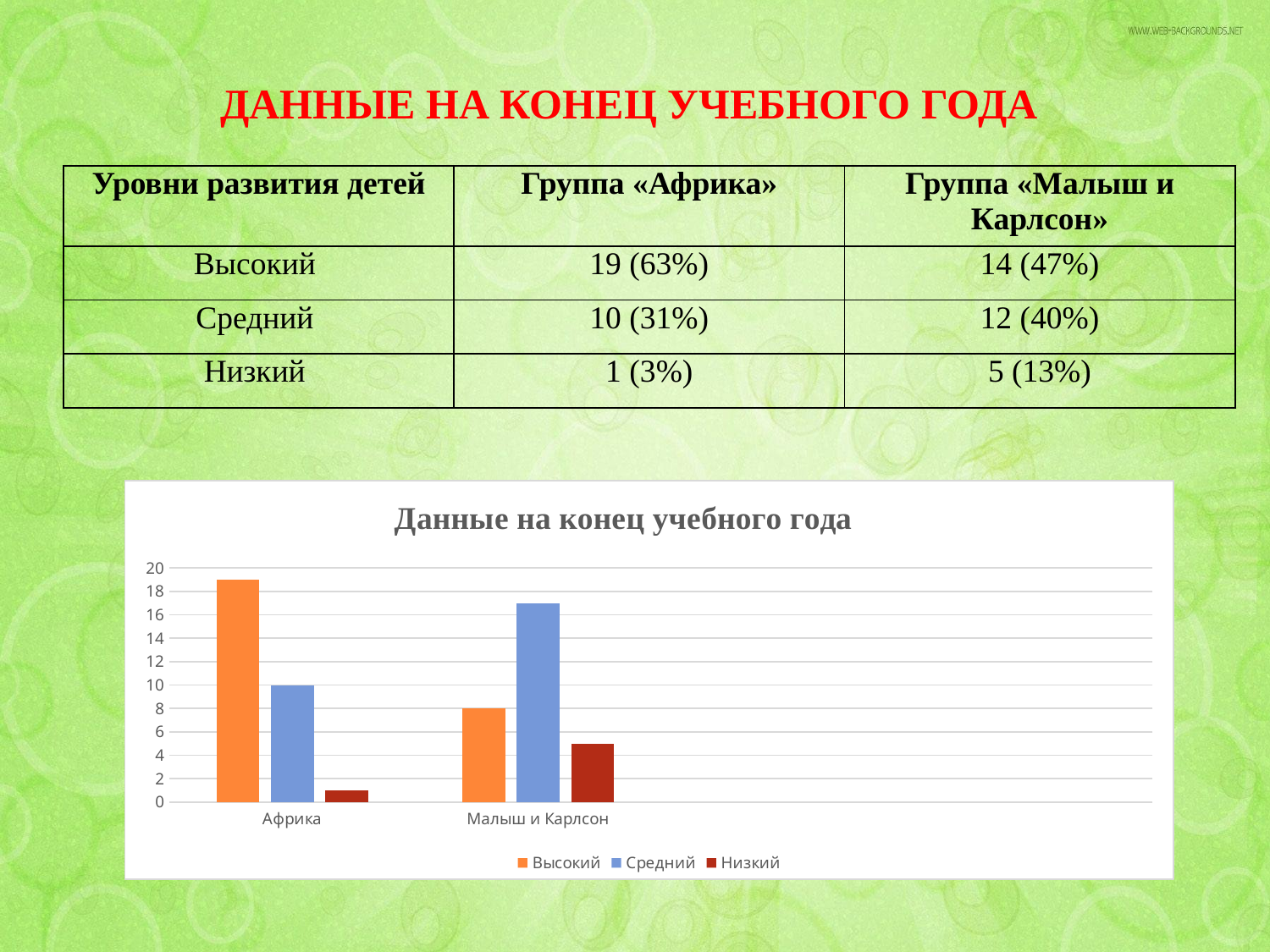
Which series has the highest bar for Малыш и Карлсон? Средний Which group has the larger Высокий bar, Африка or Малыш и Карлсон? Африка What kind of chart is shown on the slide? bar chart Which series has the lowest bar for Африка? Низкий How many series does the chart legend list? 3 Is the value of the Средний bar for Малыш и Карлсон greater or less than 16? greater What is the value of the Средний bar for Африка? 10 Is the value of the Низкий bar for Африка greater or less than 2? less How many categories are shown on the x axis of the chart? 2 Is the value of the Высокий bar for Африка greater or less than 18? greater What is the value of the Высокий bar for Малыш и Карлсон? 8 What is the title of the chart? Данные на конец учебного года